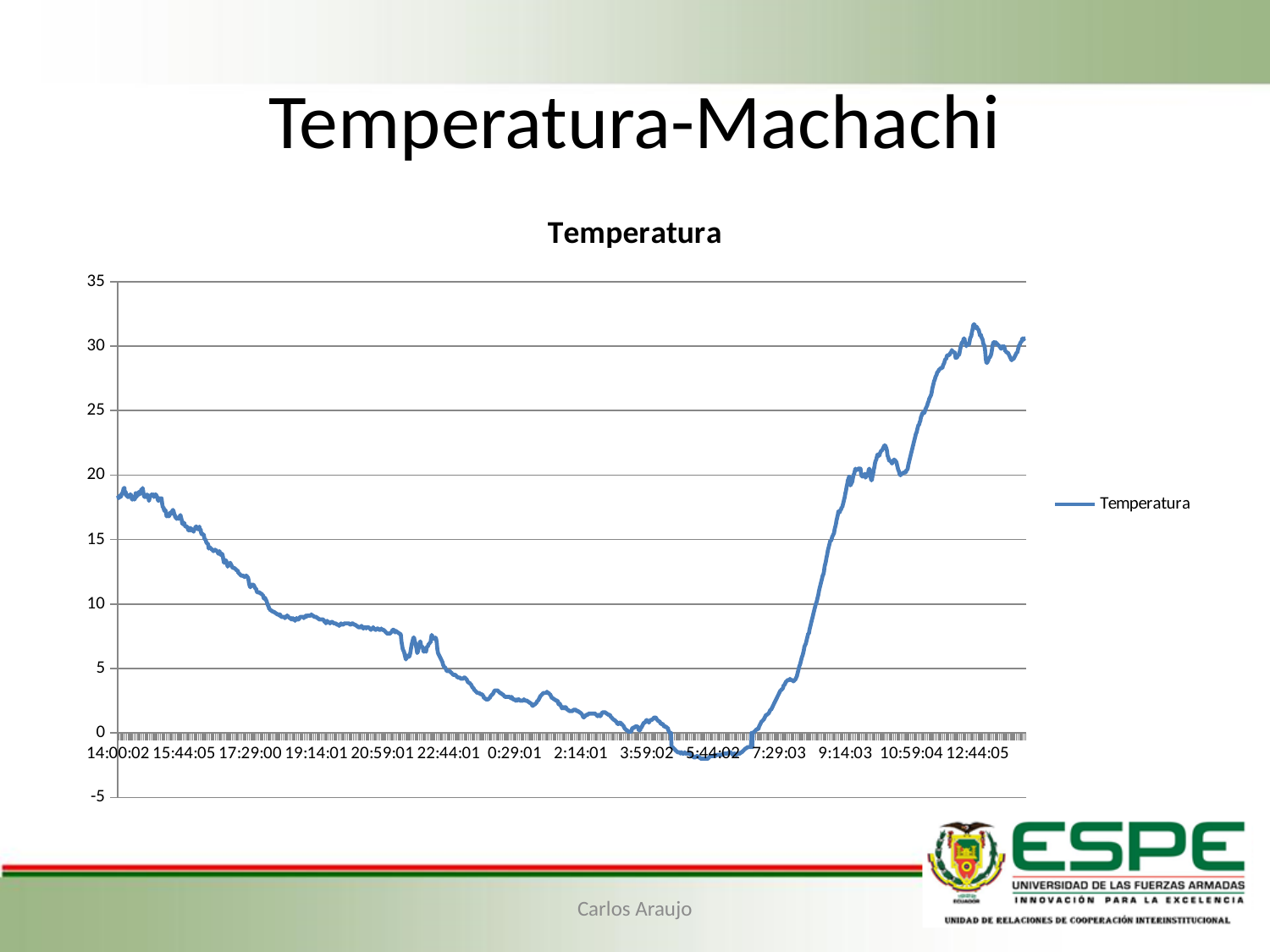
How many series does the legend list? 1 Is the value for Temperatura at 0:29:01 greater or less than 5? less What kind of chart is shown on the slide? line chart Around which x-axis label does the Temperatura line reach its lowest value? 5:44:02 Does the Temperatura line rise or fall between 5:44:02 and 12:44:05? rise What is the title of the chart? Temperatura Is the value for Temperatura at 12:44:05 greater or less than 25? greater Is the value for Temperatura at 5:44:02 greater or less than 0? less Does the Temperatura line rise or fall between 14:00:02 and 5:44:02? fall What colour is the Temperatura line? blue